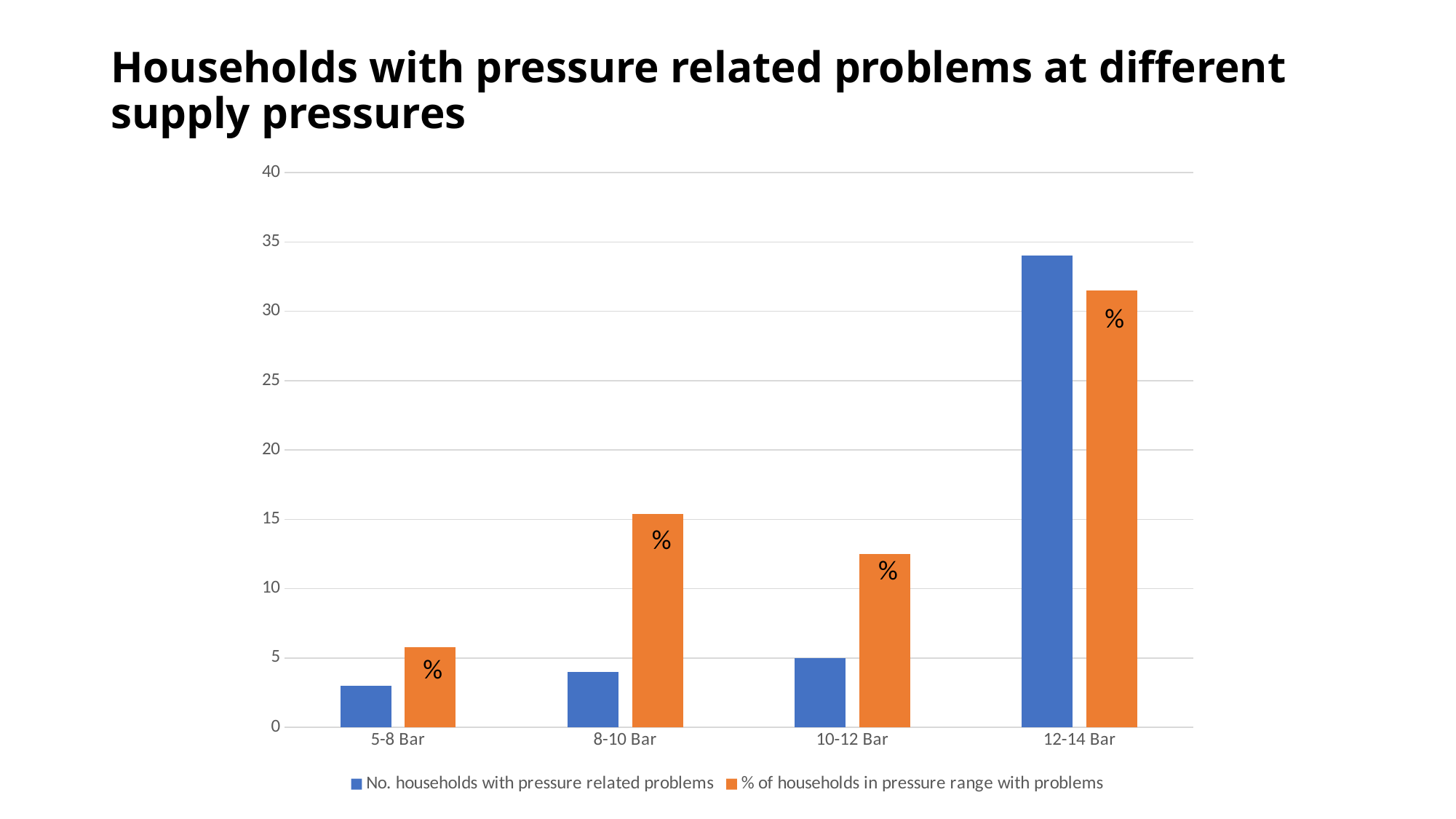
Which colour represents the % of households in pressure range with problems series? Orange How many series does the legend list? 2 Is the number of households with pressure related problems for 12-14 Bar greater or less than 30? greater Which pressure range has the lowest % of households in pressure range with problems? 5-8 Bar Do the values for No. households with pressure related problems rise or fall from 5-8 Bar to 12-14 Bar? rise What kind of chart is shown on the slide? Bar chart Is the % of households in pressure range with problems for 12-14 Bar greater or less than 35? less How many pressure ranges are shown on the x axis? 4 Which is larger: the % of households in pressure range with problems for 8-10 Bar or for 10-12 Bar? 8-10 Bar Which pressure range has the lowest number of households with pressure related problems? 5-8 Bar Which pressure range has the highest number of households with pressure related problems? 12-14 Bar Is the % of households in pressure range with problems for 5-8 Bar greater or less than 10? less